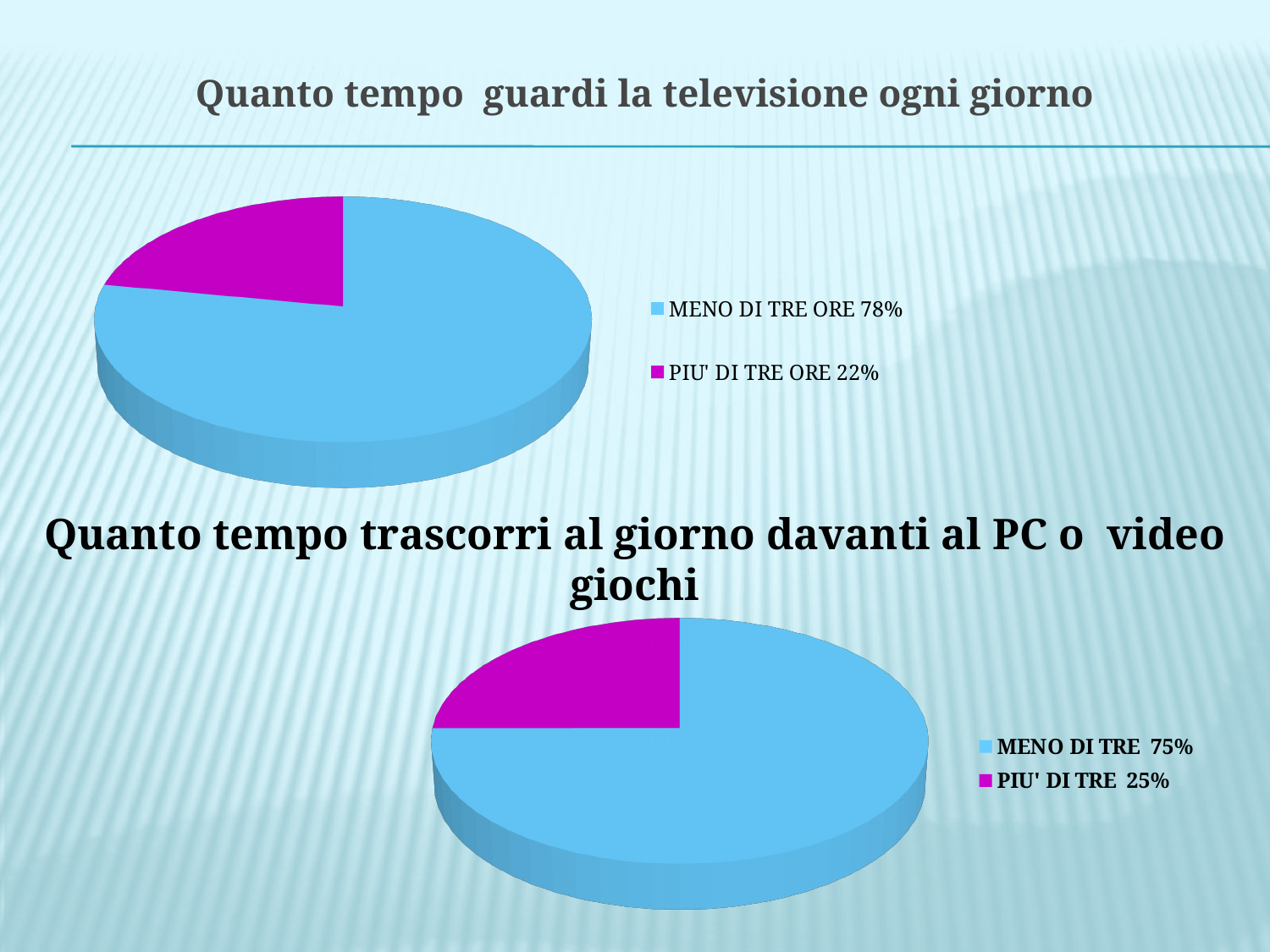
In the bottom chart (PC o video giochi), which category has the smallest slice? PIU' DI TRE In the top chart (television), what share is labelled for MENO DI TRE ORE? 78% In the top chart (television), which category has the largest slice? MENO DI TRE ORE How many slices does the bottom chart (PC o video giochi) have? 2 Which is larger: the PIU' DI TRE ORE share in the top chart or the PIU' DI TRE share in the bottom chart? PIU' DI TRE in the bottom chart In the top chart (television), what share is labelled for PIU' DI TRE ORE? 22% In the top chart (television), what is the difference between the MENO DI TRE ORE share and the PIU' DI TRE ORE share? 56% In the bottom chart (PC o video giochi), what share is labelled for PIU' DI TRE? 25% What kind of chart is the top chart on the slide? Pie chart In the bottom chart (PC o video giochi), what is the difference between the MENO DI TRE share and the PIU' DI TRE share? 50% In the top chart (television), what colour is the PIU' DI TRE ORE slice? Magenta